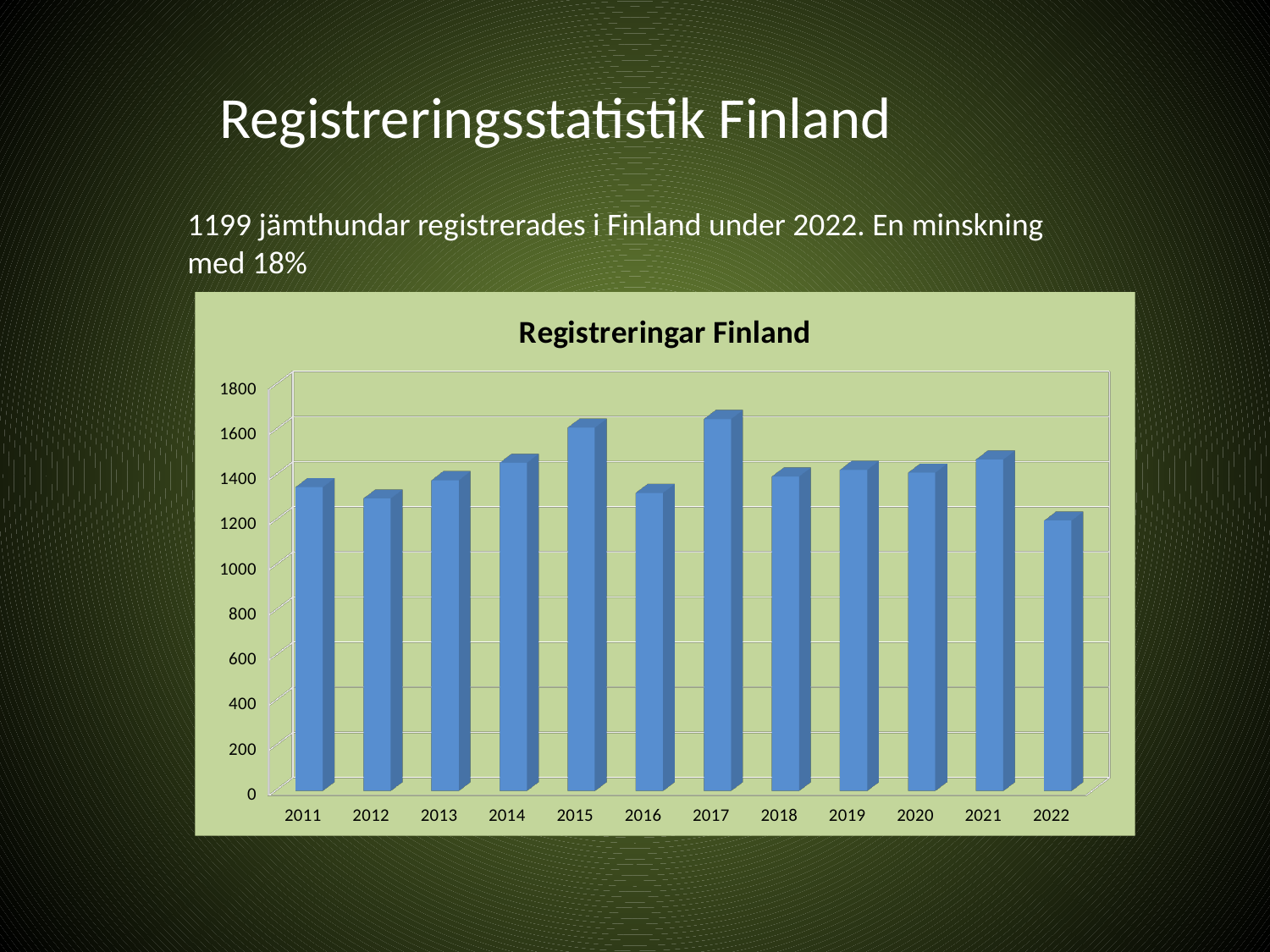
Is the value for 2012 greater or less than 1400? less Which year has the highest number of registrations in the chart? 2017 What kind of chart is shown on the slide? bar chart Is the value for 2014 greater or less than 1400? greater Is the value for 2017 greater or less than 1600? greater Do the values rise or fall from 2012 to 2015? rise Which year has more registrations, 2021 or 2022? 2021 Which year has the lowest number of registrations in the chart? 2022 According to the slide, how many jämthundar were registered in Finland in 2022? 1199 How many years are shown on the x axis of the chart? 12 What is the title of the chart? Registreringar Finland Which year has more registrations, 2015 or 2016? 2015